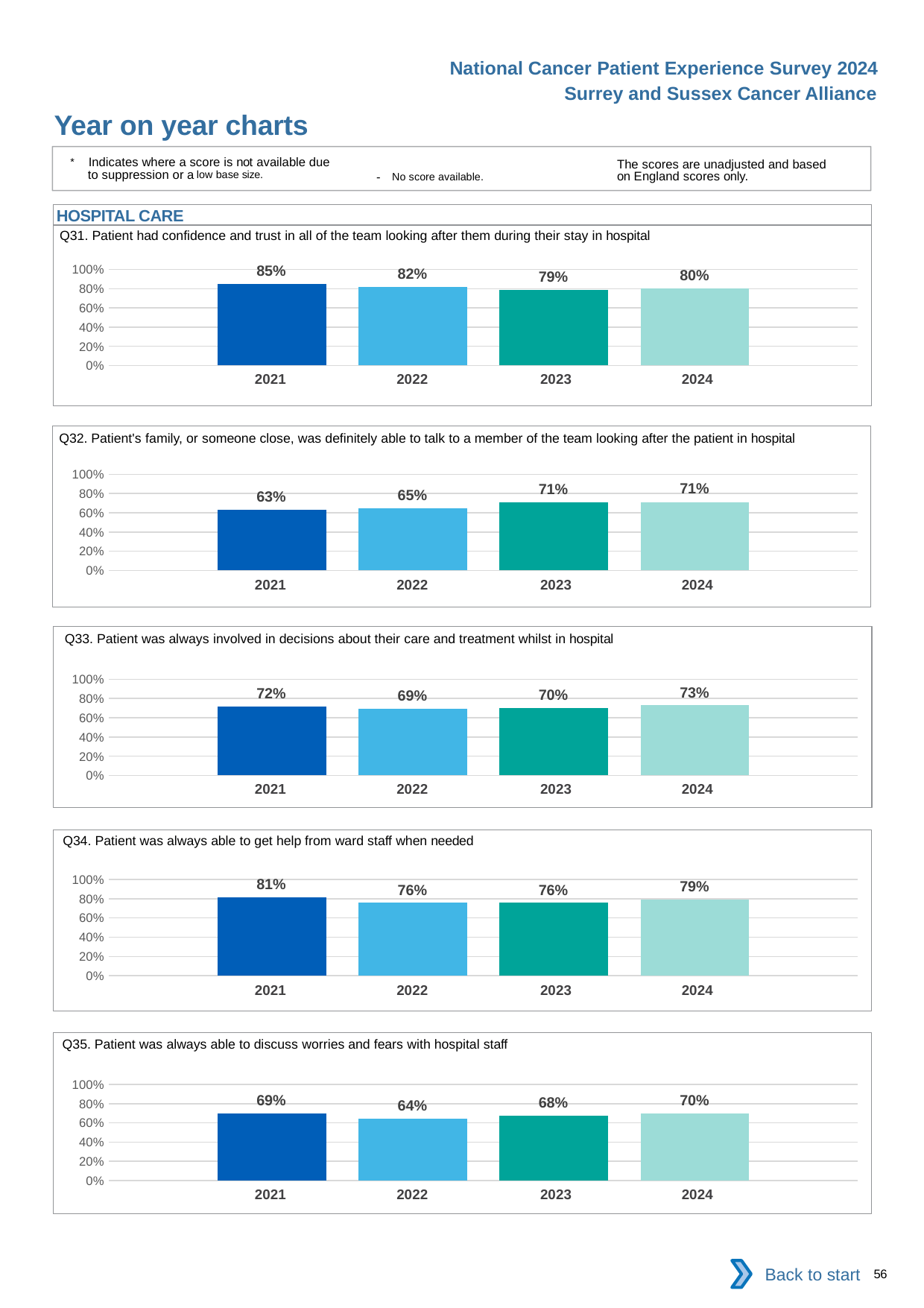
In the Q31 chart (patient had confidence and trust in all of the team), what is the value for 2021? 85% In the Q34 chart (patient was always able to get help from ward staff), which is larger, the 2021 value or the 2024 value? 2021 How many years are shown on the x axis of the Q31 chart? 4 In the Q33 chart (patient was always involved in decisions about their care), what is the value for 2022? 69% In the Q35 chart (patient was always able to discuss worries and fears), which year has the lowest value? 2022 In the Q33 chart (patient was always involved in decisions about their care), which year has the highest value? 2024 What type of chart is used for Q32 (patient's family was definitely able to talk to a member of the team)? Bar chart In the Q34 chart (patient was always able to get help from ward staff), what is the value for 2023? 76% In the Q32 chart (patient's family was definitely able to talk to a member of the team), what is the difference between the 2024 and 2021 values? 8 percentage points In the Q35 chart (patient was always able to discuss worries and fears), what is the difference between the 2024 and 2022 values? 6 percentage points In the Q31 chart (patient had confidence and trust in all of the team), which year has the lowest value? 2023 In the Q32 chart (patient's family was definitely able to talk to a member of the team), what is the value for 2022? 65%